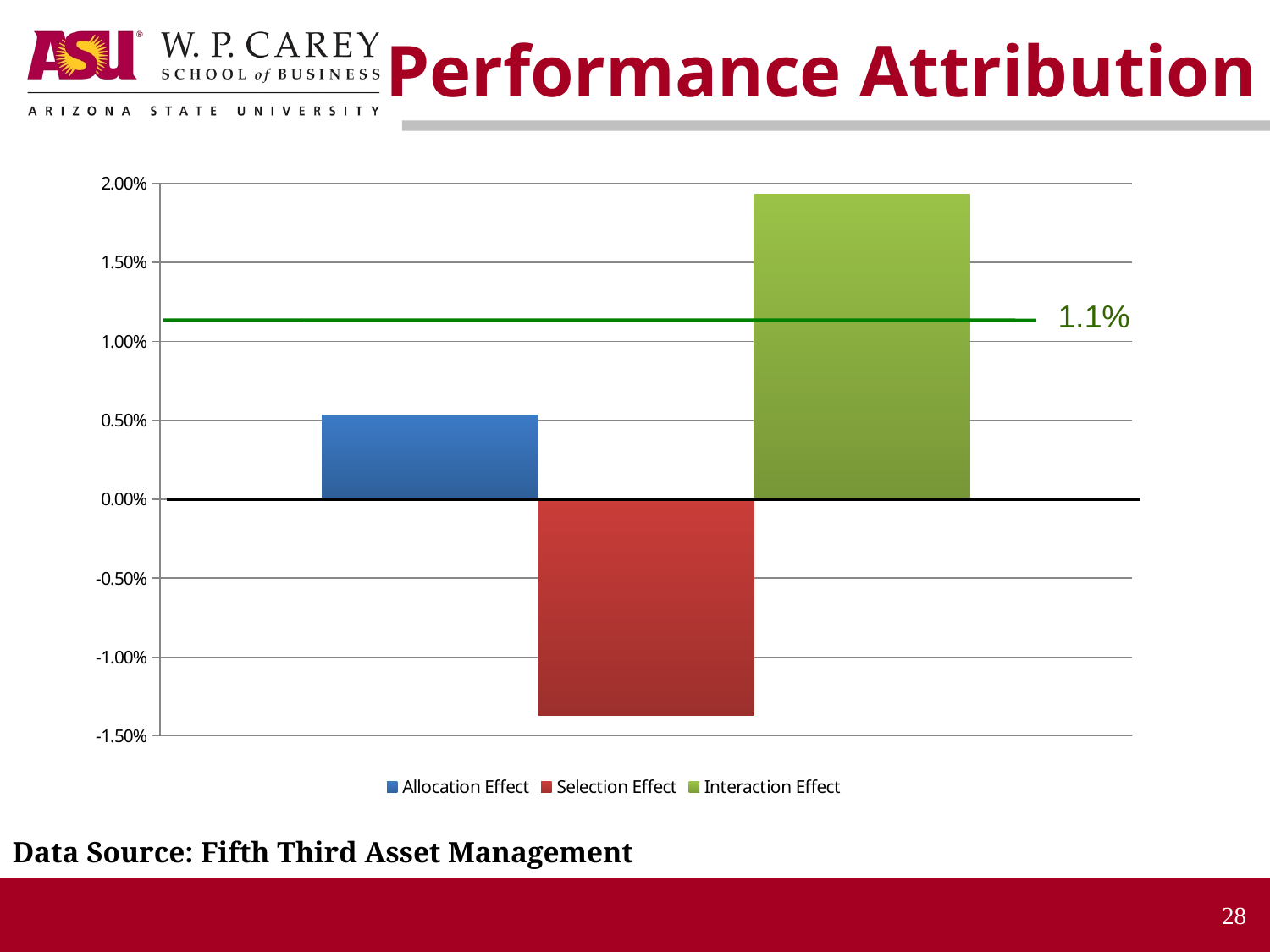
Is the value for Selection Effect greater or less than -1.00%? less What kind of chart is shown on the slide? bar chart Is the value for Interaction Effect greater or less than 1.50%? greater How many series does the legend list? 3 Which series is the only one with a negative value? Selection Effect What value is labelled on the horizontal green line drawn across the chart? 1.1% Which series has the highest value? Interaction Effect What colour is the bar for the Selection Effect? red Which is larger, the Allocation Effect or the Interaction Effect? Interaction Effect Which series has the lowest value? Selection Effect Is the value for Allocation Effect greater or less than 0.00%? greater